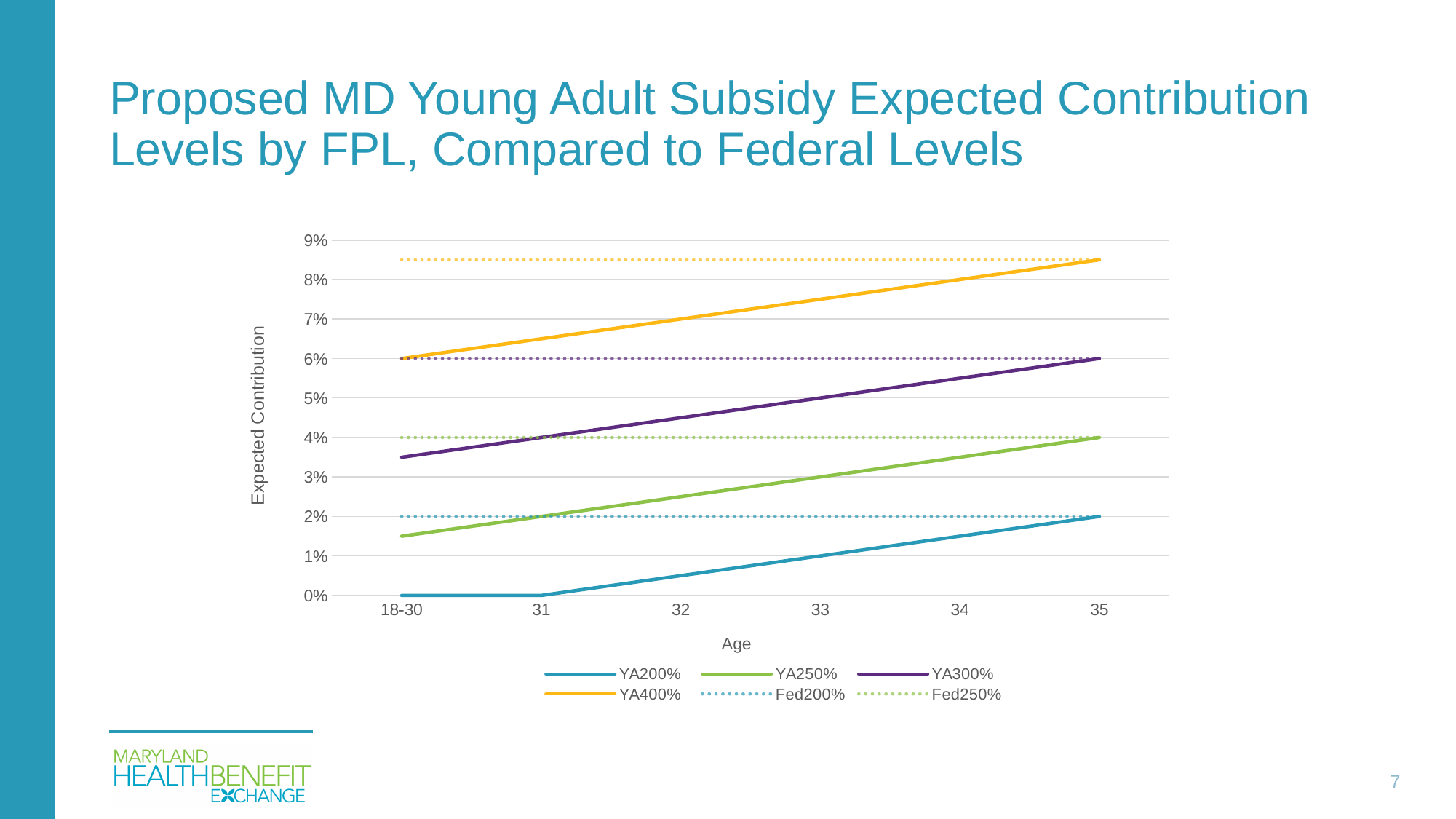
What is the expected contribution for YA400% at age 18-30? 6% What kind of chart is shown on the slide? line chart Does the YA400% line rise or fall as age increases from 18-30 to 35? rise Which series has the highest expected contribution at age 35? YA400% What is the expected contribution for YA200% at age 35? 2% How many series does the legend list? 6 What constant value does the Fed200% line sit at? 2% How many age categories are shown on the x axis? 6 Is the value for YA300% at age 18-30 greater or less than 3%? greater What is the expected contribution for YA300% at age 35? 6% At age 18-30, which is larger: YA250% or Fed200%? Fed200% What is the expected contribution for YA250% at age 35? 4%